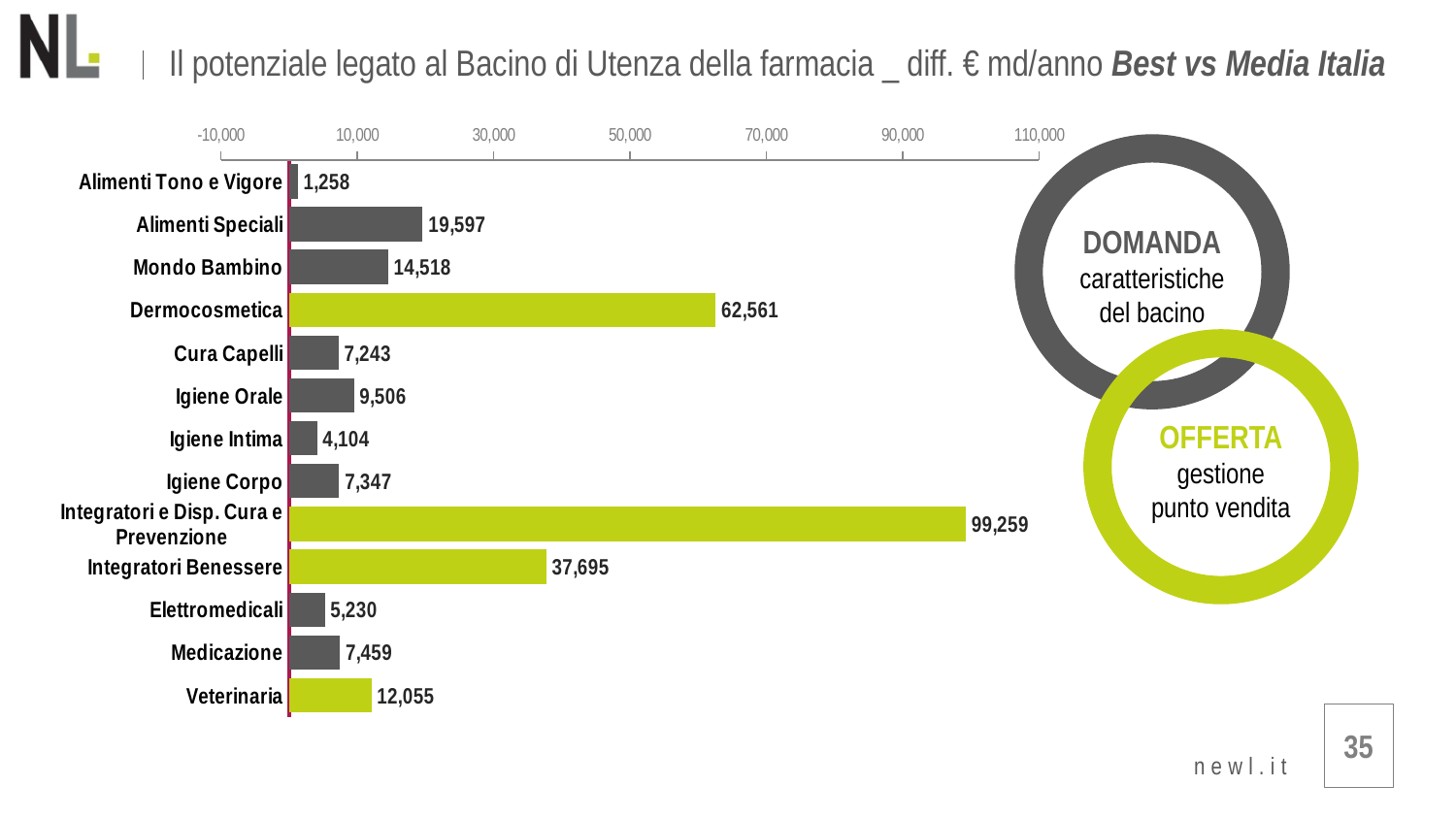
Which is larger, the value for Igiene Orale or the value for Igiene Corpo? Igiene Orale What is the difference between the values for Dermocosmetica and Integratori Benessere? 24,866 Is the value for Integratori Benessere greater or less than 30,000? greater Which category has the highest value? Integratori e Disp. Cura e Prevenzione What is the value for Dermocosmetica? 62,561 What is the difference between the values for Alimenti Speciali and Mondo Bambino? 5,079 How many categories are shown in the chart? 13 What kind of chart is shown on the slide? bar chart What is the value for Igiene Intima? 4,104 What is the value for Mondo Bambino? 14,518 What is the value for Veterinaria? 12,055 Which category has the lowest value? Alimenti Tono e Vigore